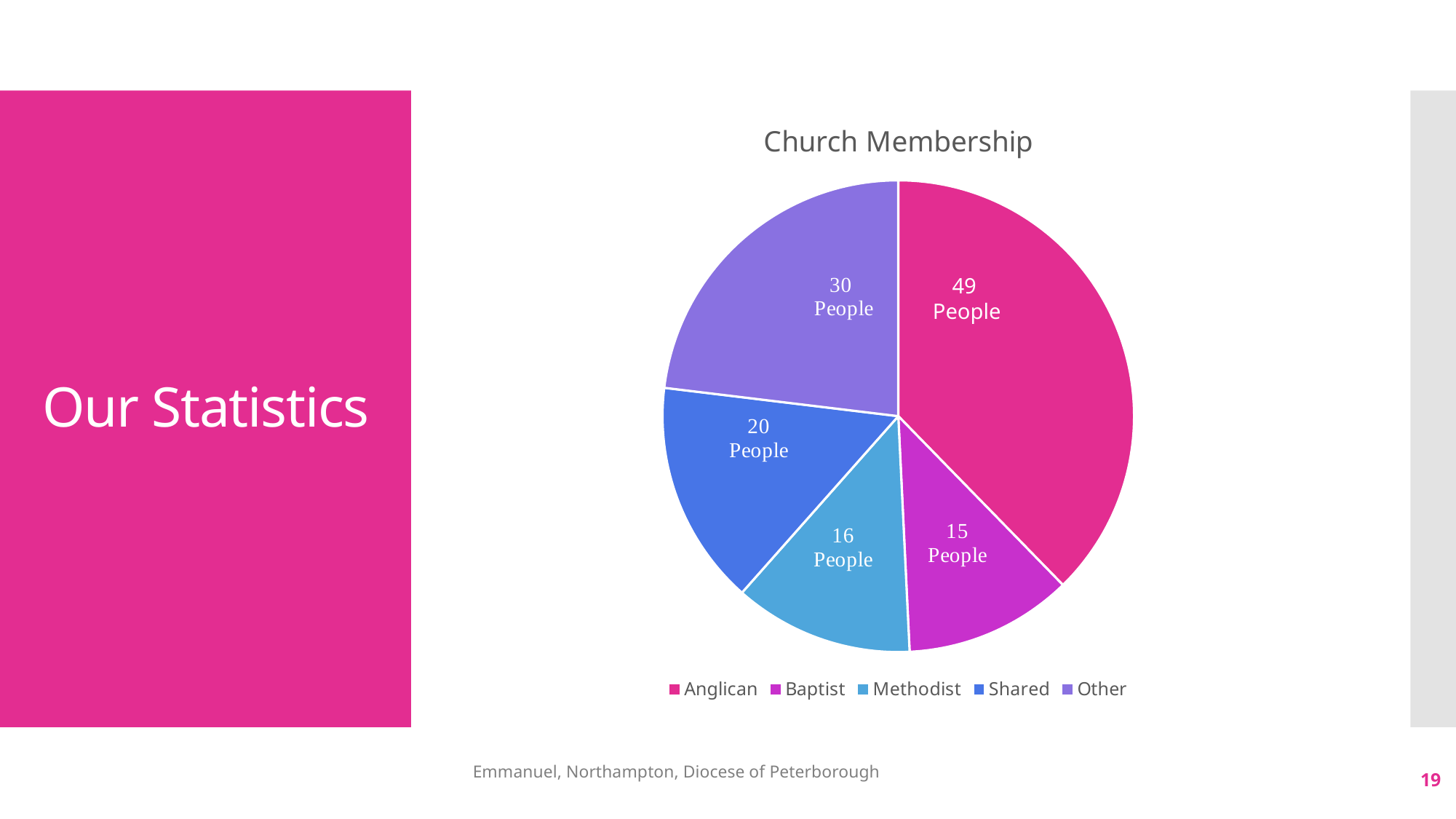
What is the title of the chart? Church Membership What type of chart is shown on the slide? Pie chart How many people are in the Methodist slice? 16 People How many people are in the Anglican slice? 49 People Which is larger, the Shared slice or the Methodist slice? Shared How many people are in the Other slice? 30 People Which legend entry is shown in light blue? Methodist What is the total number of people across all slices? 130 How many more people are Anglican than Other? 19 How many categories does the pie chart have? 5 Which category has the smallest slice of the pie? Baptist Which category has the largest slice of the pie? Anglican